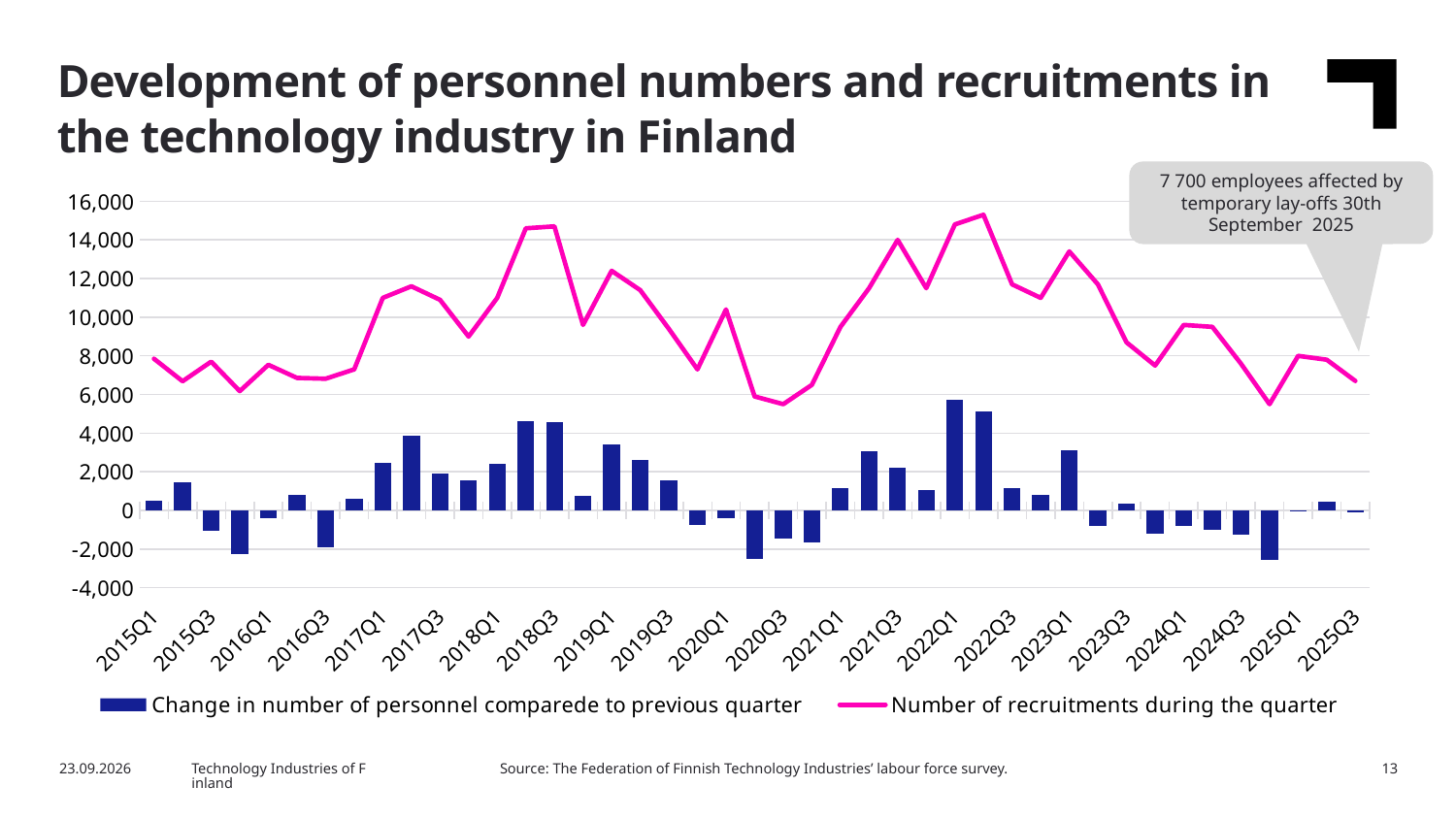
Which quarter has a higher number of recruitments, 2022Q1 or 2025Q3? 2022Q1 Is the number of recruitments in 2022Q1 greater or less than 14,000? greater What is the title of the chart? Development of personnel numbers and recruitments in the technology industry in Finland Does the number of recruitments generally rise or fall from 2022Q1 to 2025Q3? fall Is the number of recruitments in 2020Q3 greater or less than 8,000? less Is the change in number of personnel in 2020Q3 greater or less than 0? less How many series does the legend list? 2 In which quarter does the number of recruitments during the quarter reach its highest value? 2022Q2 In which quarter is the change in number of personnel compared to previous quarter the highest? 2022Q1 Which series is drawn as a line? Number of recruitments during the quarter What kind of chart is shown on the slide? A combined bar and line chart